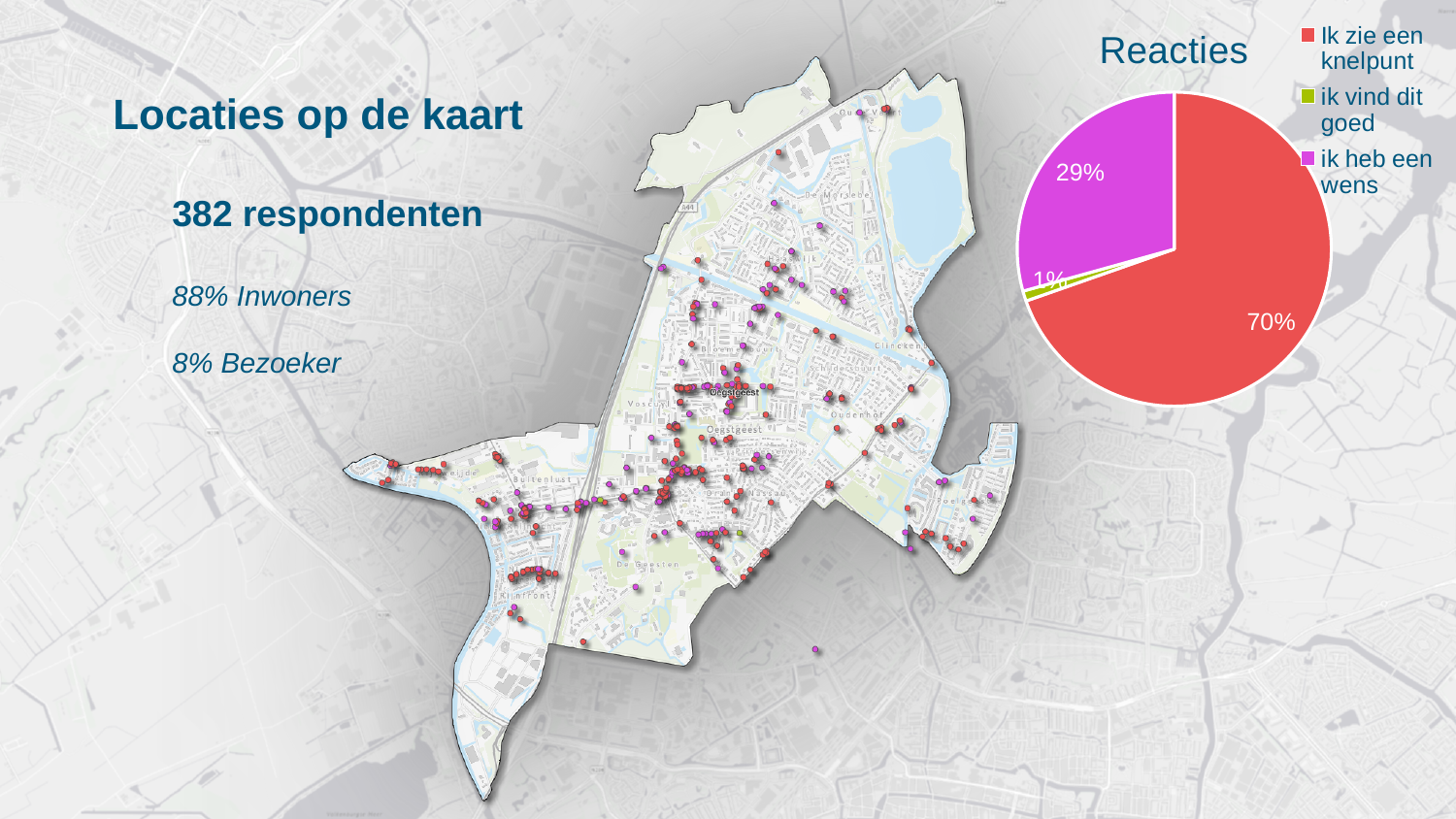
How many slices does the 'Reacties' pie chart have? 3 In the 'Reacties' pie chart, what share is labelled for 'ik vind dit goed'? 1% In the 'Reacties' pie chart, what share is labelled for 'Ik zie een knelpunt'? 70% In the 'Reacties' pie chart, which is larger: 'ik heb een wens' or 'ik vind dit goed'? ik heb een wens Which category has the largest slice in the 'Reacties' pie chart? Ik zie een knelpunt In the 'Reacties' pie chart, what is the difference in percentage points between 'Ik zie een knelpunt' and 'ik heb een wens'? 41 Which category has the smallest slice in the 'Reacties' pie chart? ik vind dit goed What is the title of the pie chart on the slide? Reacties What kind of chart is the 'Reacties' chart? pie chart How many entries does the legend of the 'Reacties' pie chart list? 3 In the 'Reacties' pie chart, what colour is the slice for 'ik heb een wens'? magenta/purple In the 'Reacties' pie chart, what share is labelled for 'ik heb een wens'? 29%